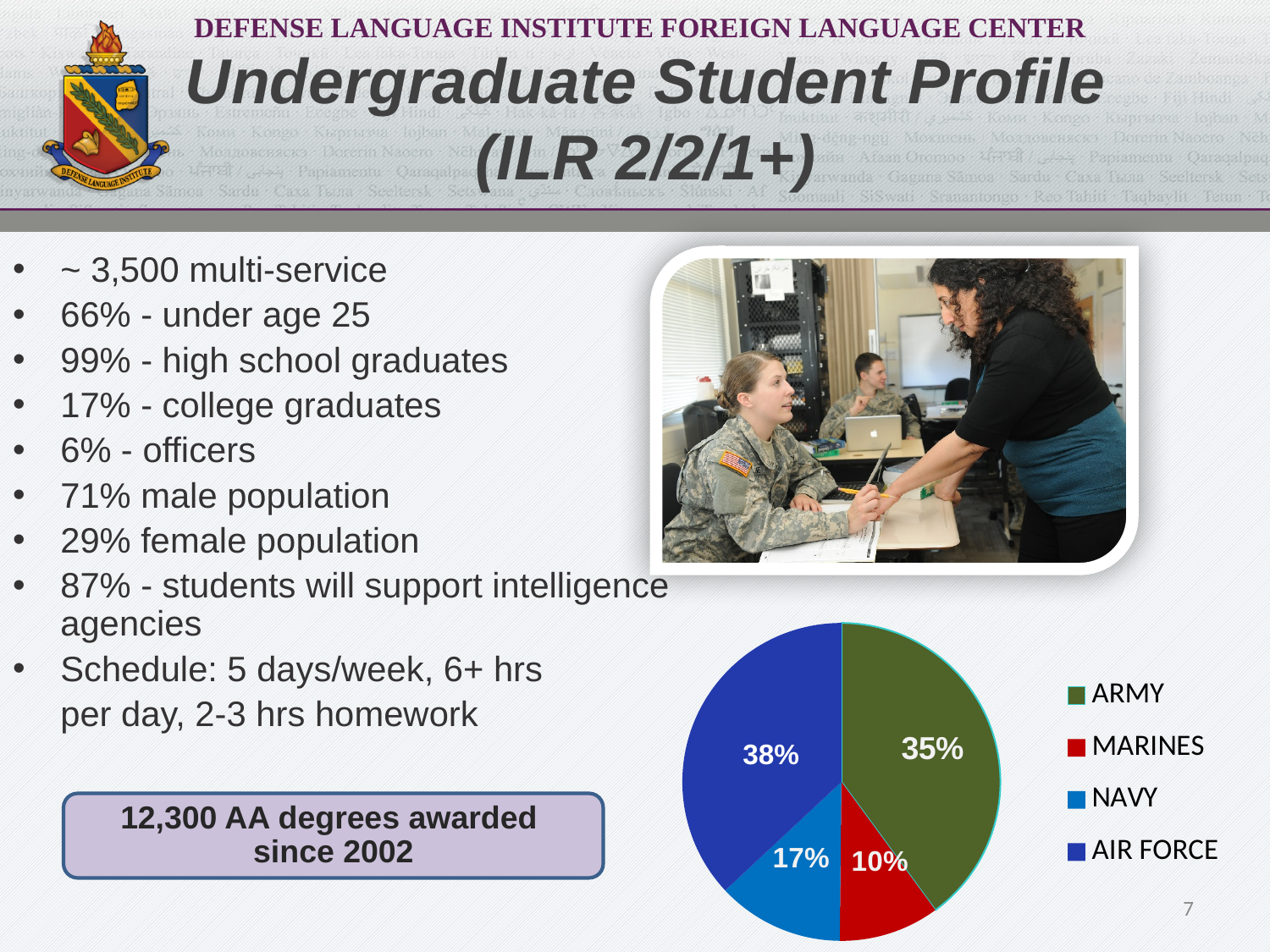
How many slices does the pie chart have? 4 What is the difference in percentage points between the NAVY and MARINES slices? 7 What colour is the ARMY slice in the pie chart? green Which slice is larger, NAVY or MARINES? NAVY Which service has the largest slice of the pie chart? AIR FORCE What share of the pie chart does NAVY represent? 17% What kind of chart is shown on the slide? pie chart Which service has the smallest slice of the pie chart? MARINES What is the difference in percentage points between the AIR FORCE and ARMY slices? 3 What share of the pie chart does MARINES represent? 10% What share of the pie chart does AIR FORCE represent? 38% What share of the pie chart does ARMY represent? 35%